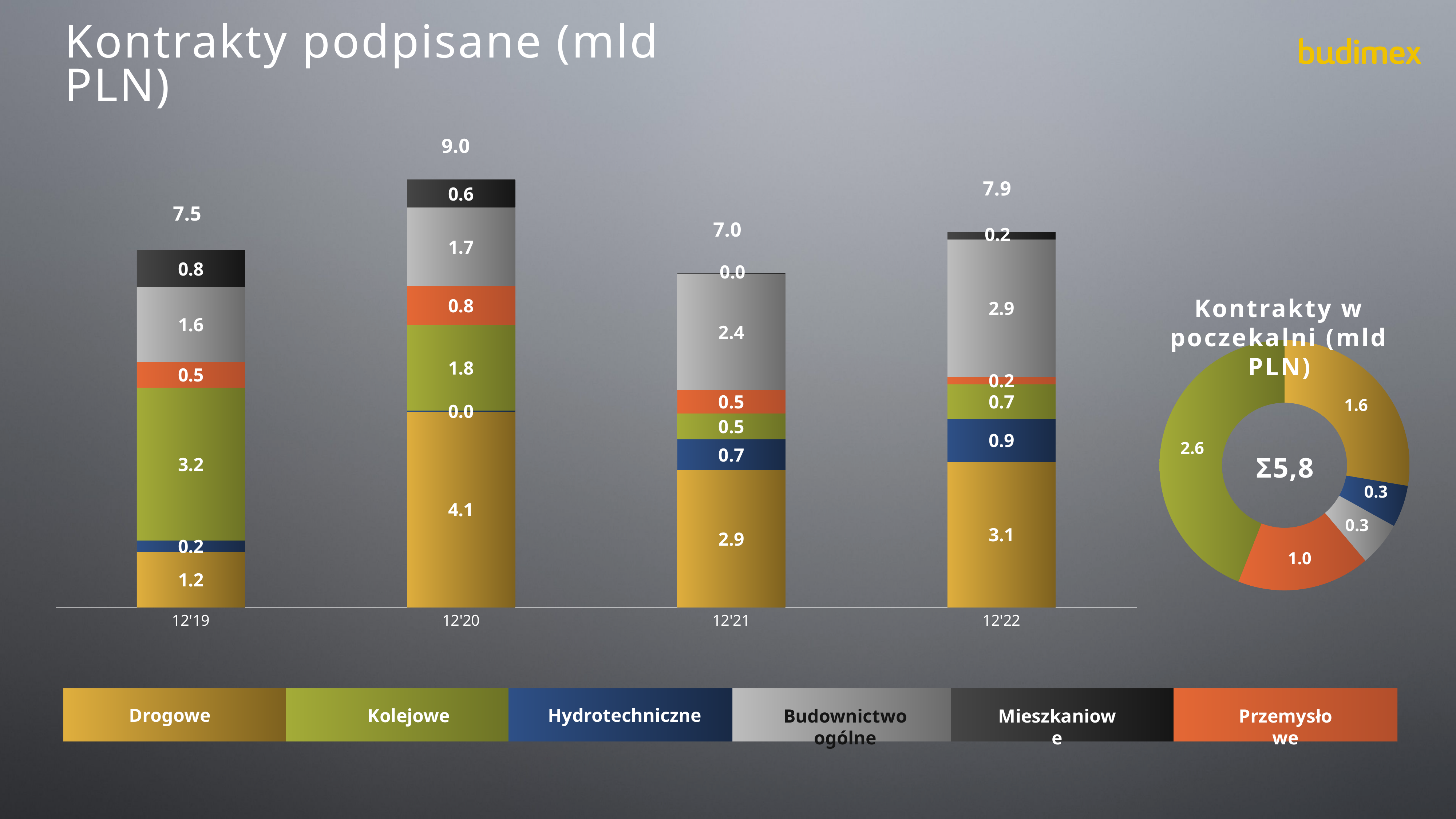
In the 'Kontrakty podpisane (mld PLN)' chart, what is the Drogowe value for 12'22? 3.1 In the 'Kontrakty podpisane (mld PLN)' chart, which period has the highest total? 12'20 In the 'Kontrakty podpisane (mld PLN)' chart, what is the total for 12'20? 9.0 In the 'Kontrakty podpisane (mld PLN)' chart, which period has the lowest total? 12'21 In the 'Kontrakty podpisane (mld PLN)' chart, what is the Kolejowe value for 12'19? 3.2 In the 'Kontrakty podpisane (mld PLN)' chart, is the Drogowe value larger for 12'20 or for 12'21? 12'20 How many series does the legend of the 'Kontrakty podpisane (mld PLN)' chart list? 6 How many periods are shown on the x axis of the 'Kontrakty podpisane (mld PLN)' chart? 4 In the 'Kontrakty podpisane (mld PLN)' chart, what is the Budownictwo ogólne value for 12'21? 2.4 In the 'Kontrakty podpisane (mld PLN)' chart, what is the difference between the totals for 12'20 and 12'19? 1.5 In the 'Kontrakty w poczekalni (mld PLN)' chart, what is the total shown in the centre? Σ5,8 What kind of chart is 'Kontrakty w poczekalni (mld PLN)'? Donut chart